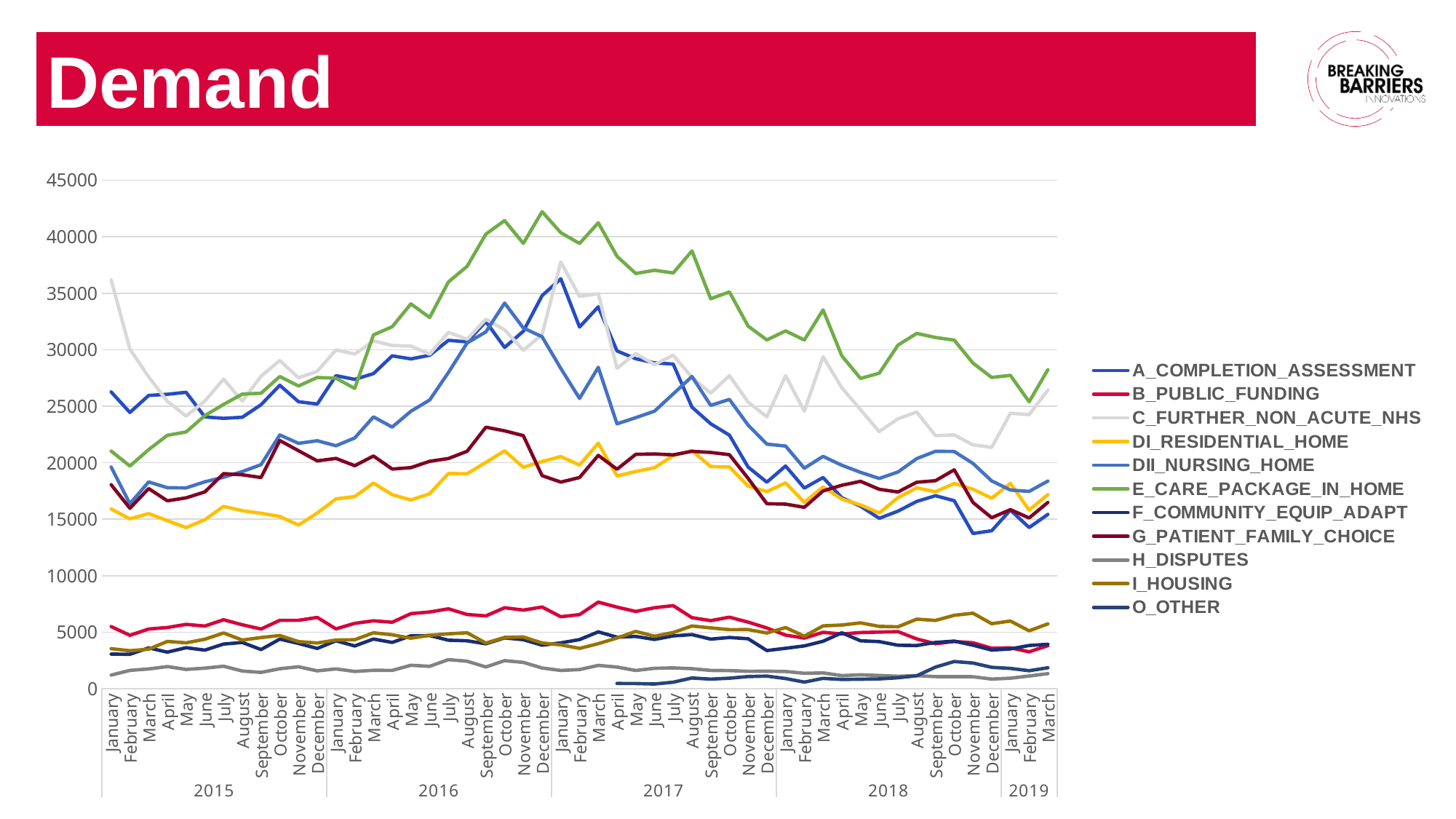
In December 2016, which series has the highest value? E_CARE_PACKAGE_IN_HOME What kind of chart is shown on the slide? line chart What is the title of the slide containing the chart? Demand How many series does the legend list? 11 Is the value for A_COMPLETION_ASSESSMENT in November 2018 greater or less than 15000? less In March 2019, which is larger: E_CARE_PACKAGE_IN_HOME or A_COMPLETION_ASSESSMENT? E_CARE_PACKAGE_IN_HOME Is the value for E_CARE_PACKAGE_IN_HOME in December 2016 greater or less than 40000? greater Which series reaches the highest value anywhere on the chart? E_CARE_PACKAGE_IN_HOME How many years are labelled along the x axis? 5 Is the value for B_PUBLIC_FUNDING in March 2017 greater or less than 10000? less Does E_CARE_PACKAGE_IN_HOME generally rise or fall from December 2016 to March 2019? fall